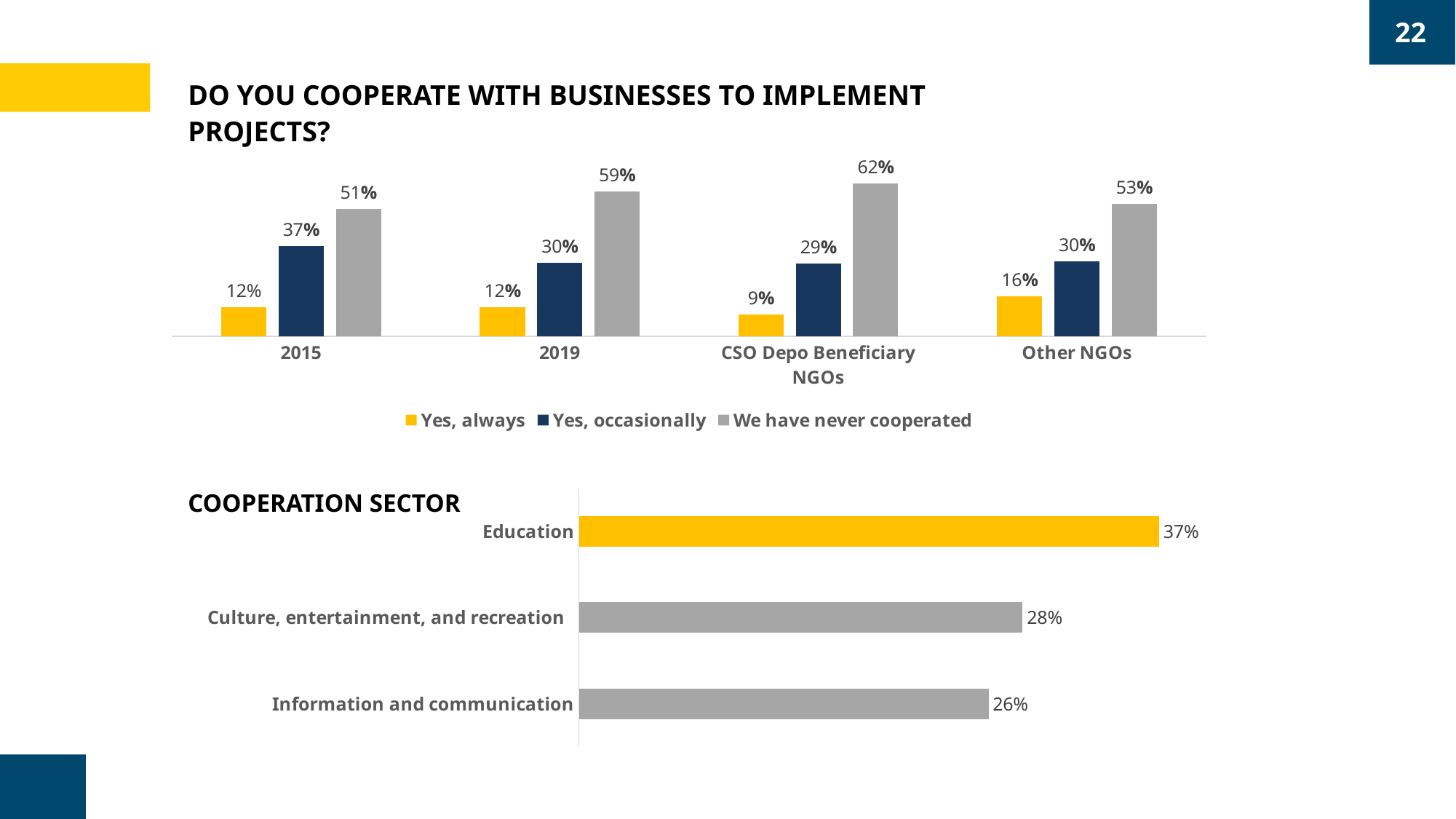
What kind of chart is the bottom chart 'Cooperation sector'? Bar chart In the bottom chart 'Cooperation sector', what is the value for Culture, entertainment, and recreation? 28% In the bottom chart 'Cooperation sector', which sector has the highest value? Education In the top chart 'Do you cooperate with businesses to implement projects?', what is the difference between 'We have never cooperated' and 'Yes, occasionally' for Other NGOs? 23% In the bottom chart 'Cooperation sector', what is the difference between Education and Information and communication? 11% In the top chart 'Do you cooperate with businesses to implement projects?', what is the value for 'Yes, occasionally' in 2015? 37% In the top chart 'Do you cooperate with businesses to implement projects?', what is the value for 'We have never cooperated' in 2019? 59% In the top chart 'Do you cooperate with businesses to implement projects?', which category has the lowest value for 'Yes, always'? CSO Depo Beneficiary NGOs In the top chart 'Do you cooperate with businesses to implement projects?', which category has the highest value for 'We have never cooperated'? CSO Depo Beneficiary NGOs In the top chart 'Do you cooperate with businesses to implement projects?', what is the value for 'Yes, always' for CSO Depo Beneficiary NGOs? 9% How many series does the legend of the top chart 'Do you cooperate with businesses to implement projects?' list? 3 In the top chart 'Do you cooperate with businesses to implement projects?', which is larger: 'Yes, always' for Other NGOs or 'Yes, always' for 2019? Other NGOs